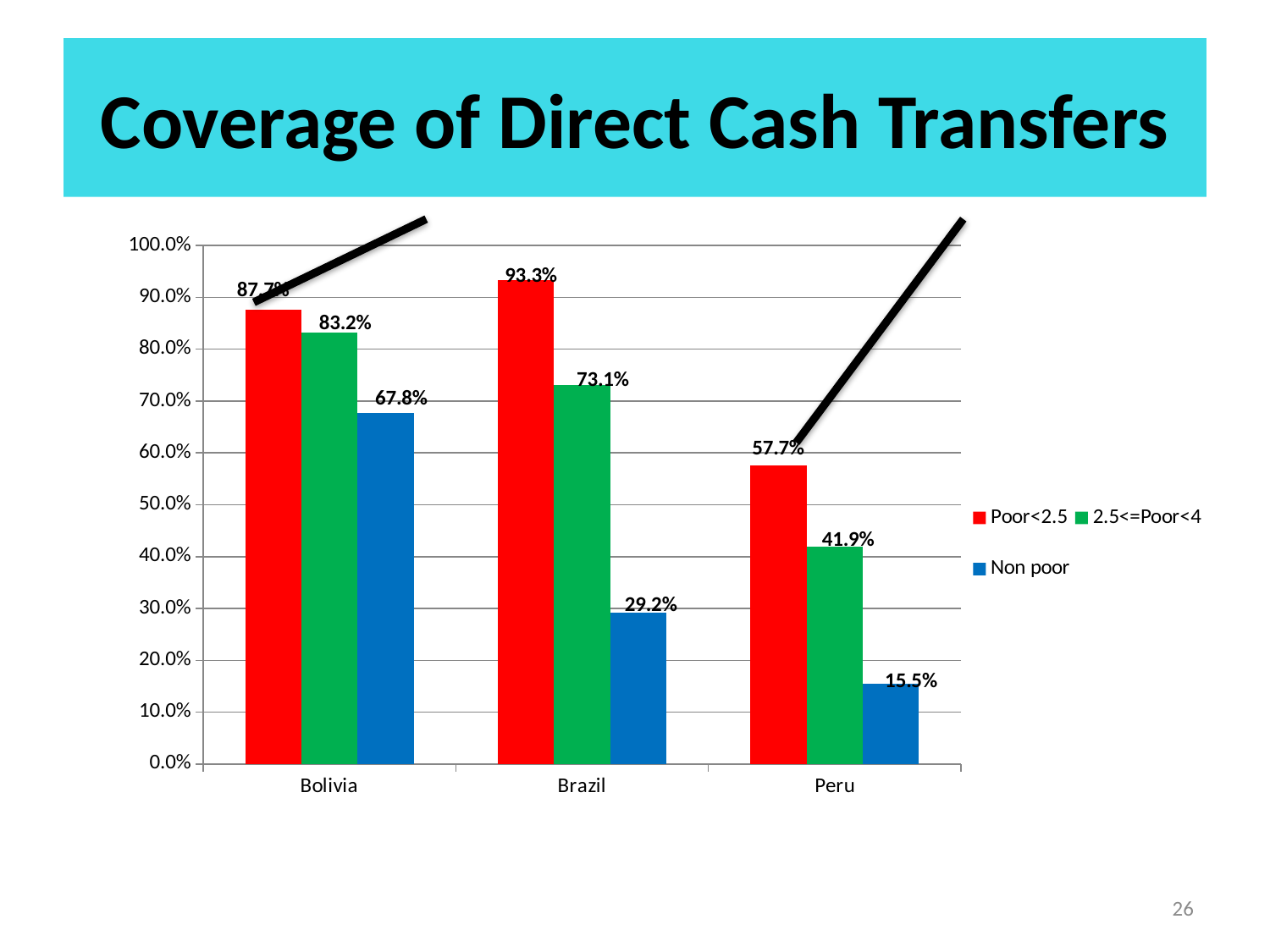
What is the value for Non poor in Bolivia? 67.8% Which country has the lowest value for Non poor? Peru How many countries are shown on the x axis? 3 What is the value for 2.5<=Poor<4 in Peru? 41.9% Which country has the highest value for Poor<2.5? Brazil What is the value for Poor<2.5 in Brazil? 93.3% Which is larger: the 2.5<=Poor<4 value in Bolivia or the 2.5<=Poor<4 value in Brazil? Bolivia What is the difference between the 2.5<=Poor<4 value and the Non poor value in Brazil? 43.9% How many series does the legend list? 3 Does the Non poor value fall or rise from Bolivia to Peru? fall What is the value for Non poor in Brazil? 29.2% What type of chart is shown on the slide? bar chart